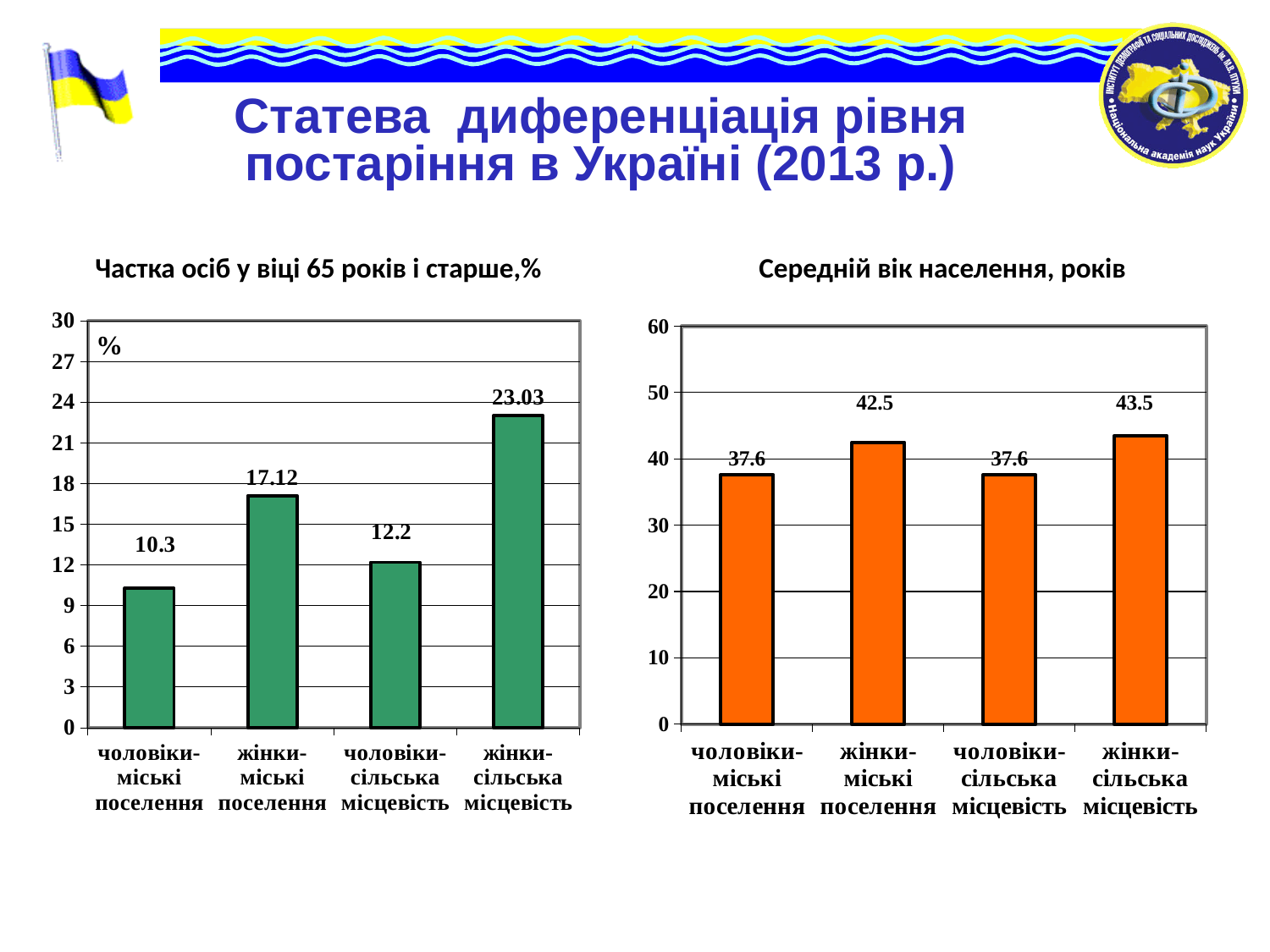
What type of chart is the one titled "Частка осіб у віці 65 років і старше,%"? bar chart In the chart titled "Частка осіб у віці 65 років і старше,%", what is the value for чоловіки-міські поселення? 10.3 In the chart titled "Середній вік населення, років", what is the value for жінки-міські поселення? 42.5 What colour are the bars in the chart titled "Середній вік населення, років"? orange In the chart titled "Частка осіб у віці 65 років і старше,%", which category has the lowest value? чоловіки-міські поселення In the chart titled "Середній вік населення, років", which category has the highest value? жінки-сільська місцевість In the chart titled "Частка осіб у віці 65 років і старше,%", how many bars are plotted? 4 In the chart titled "Частка осіб у віці 65 років і старше,%", what is the value for жінки-сільська місцевість? 23.03 In the chart titled "Середній вік населення, років", is the value for жінки-міські поселення greater or less than 40? greater In the chart titled "Середній вік населення, років", what is the value for чоловіки-сільська місцевість? 37.6 In the chart titled "Частка осіб у віці 65 років і старше,%", what is the difference between жінки-міські поселення and чоловіки-міські поселення? 6.82 In the chart titled "Середній вік населення, років", what is the difference between жінки-сільська місцевість and чоловіки-сільська місцевість? 5.9